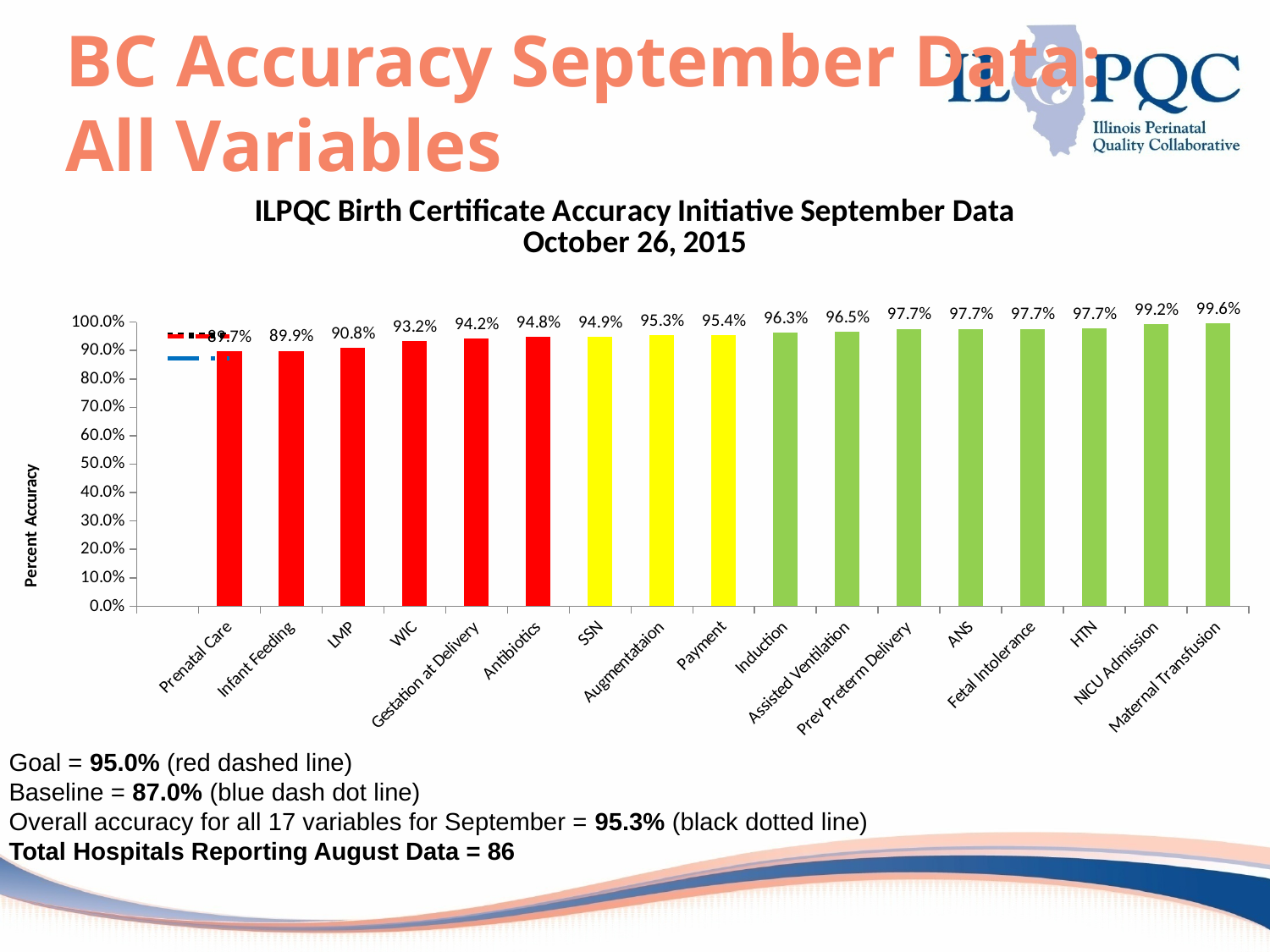
What is the label on the y axis? Percent Accuracy Which category has the highest value? Maternal Transfusion What is the value for WIC? 93.2% What is the value for Maternal Transfusion? 99.6% What is the value for Induction? 96.3% Do the values rise or fall from left to right along the x axis? rise What kind of chart is this? bar chart Is the value for Infant Feeding greater or less than 90.0%? less How many categories are shown on the x axis? 17 What is the value for Payment? 95.4% Which is larger, the value for Assisted Ventilation or the value for Antibiotics? Assisted Ventilation What is the difference between the values for NICU Admission and LMP? 8.4%